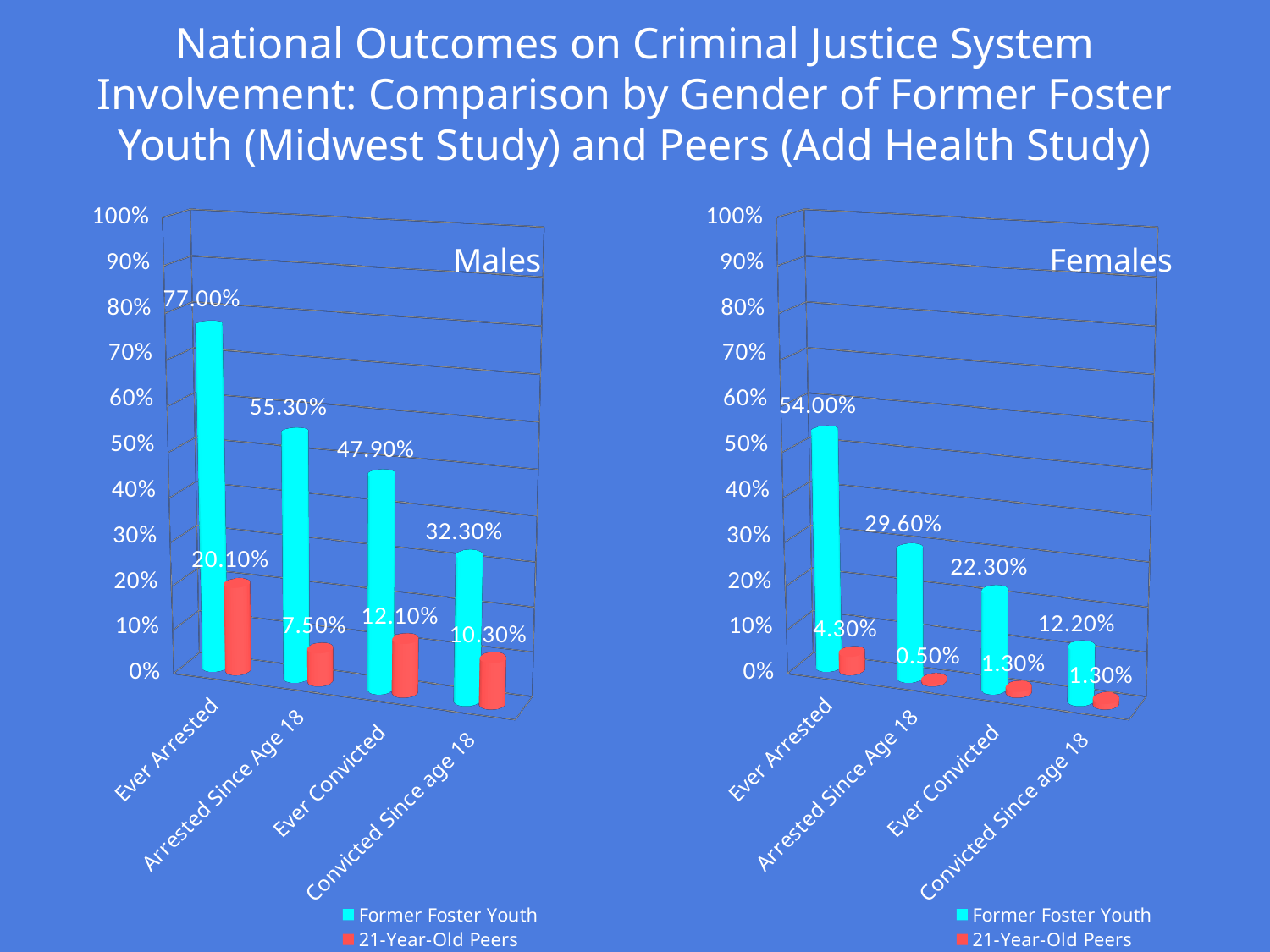
How many series does the legend of the Males chart list? 2 What kind of chart is the Females chart? Bar chart In the Males chart, what is the value for Former Foster Youth for Ever Arrested? 77.00% In the Males chart, which category has the highest value for Former Foster Youth? Ever Arrested In the Females chart, what is the value for Former Foster Youth for Ever Convicted? 22.30% In the Males chart, which is larger for Convicted Since age 18: Former Foster Youth or 21-Year-Old Peers? Former Foster Youth In the Males chart, what is the value for 21-Year-Old Peers for Arrested Since Age 18? 7.50% In the Females chart, what is the difference between Former Foster Youth and 21-Year-Old Peers for Ever Arrested? 49.70% How many categories are shown on the x axis of the Females chart? 4 In the Females chart, what is the value for 21-Year-Old Peers for Arrested Since Age 18? 0.50% In the Males chart, what is the difference between Former Foster Youth and 21-Year-Old Peers for Ever Convicted? 35.80% In the Females chart, which category has the lowest value for 21-Year-Old Peers? Arrested Since Age 18